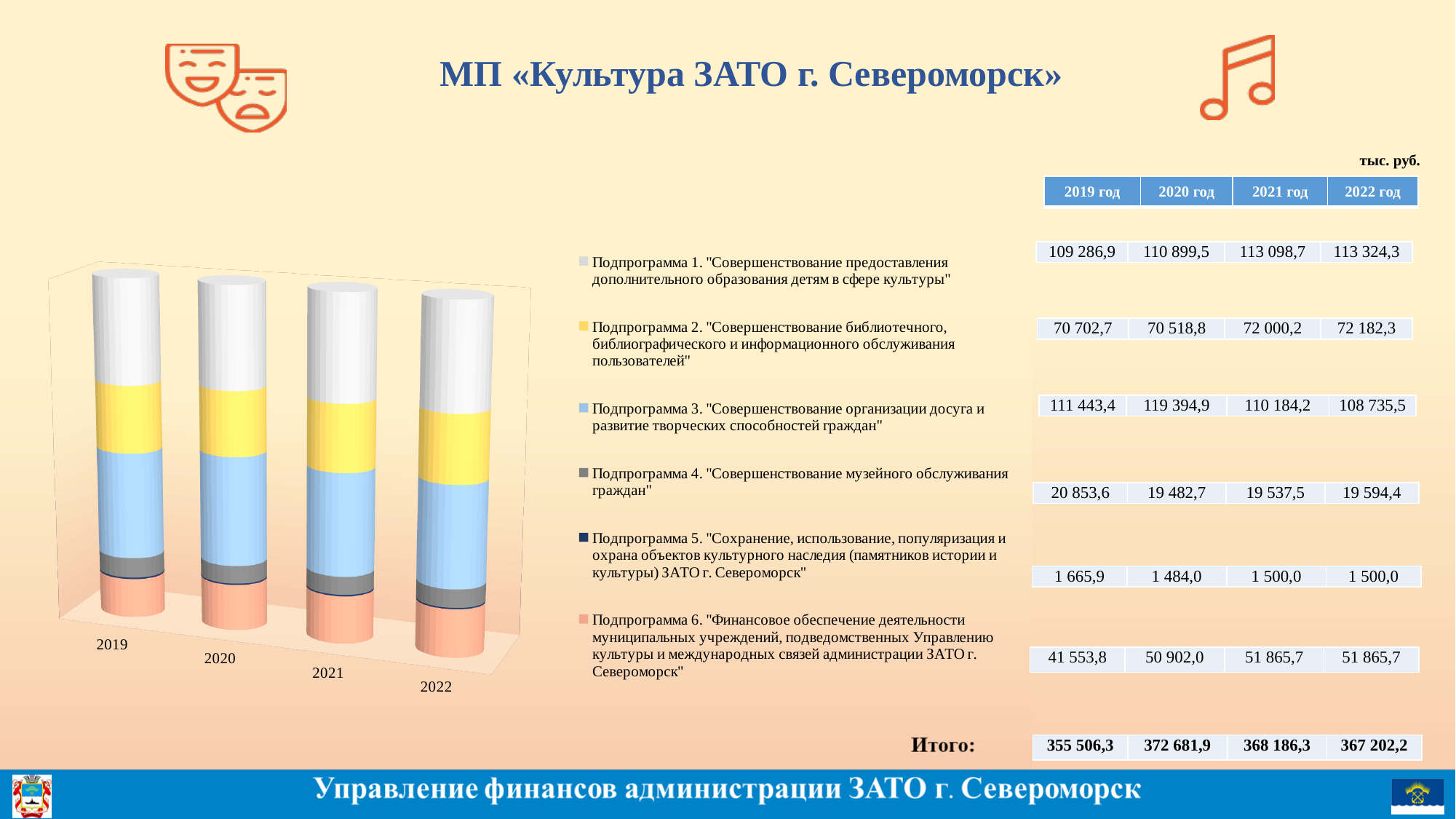
What is the total (Итого) of the stacked bar for 2020 год? 372 681,9 Which year has the lowest total (Итого)? 2019 год What kind of chart is shown on the slide? Stacked bar chart How many years (categories) are plotted on the x axis of the chart? 4 What is the value for Подпрограмма 6 in 2022 год? 51 865,7 What is the value for Подпрограмма 1 in 2019 год? 109 286,9 Is the value for Подпрограмма 3 larger in 2019 год or in 2020 год? 2020 год What is the value for Подпрограмма 3 in 2020 год? 119 394,9 Which year has the highest total (Итого)? 2020 год How many series (subprograms) does the legend list? 6 Which subprogram has the smallest value in 2021 год? Подпрограмма 5 What is the difference between the values for Подпрограмма 4 in 2019 год and 2020 год? 1 370,9